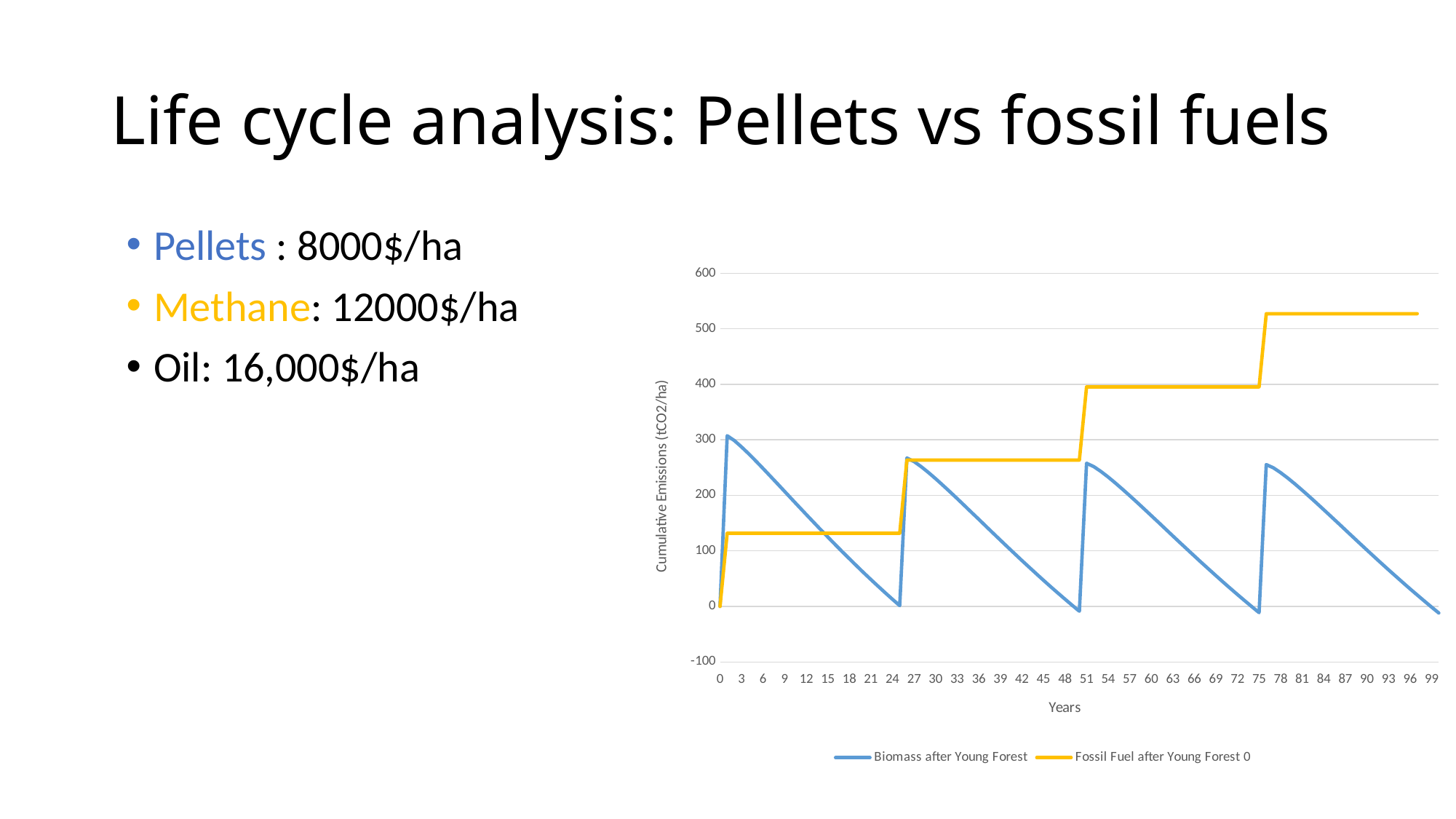
Is the value of Fossil Fuel after Young Forest 0 at year 90 greater or less than 500? greater At year 12, which series has the higher value, Biomass after Young Forest or Fossil Fuel after Young Forest 0? Biomass after Young Forest Which series is drawn in yellow on the chart? Fossil Fuel after Young Forest 0 What kind of chart is shown on the slide? line chart Is the value of Biomass after Young Forest at year 12 greater or less than 100? greater What is the title of the vertical axis of the chart? Cumulative Emissions (tCO2/ha) Does the Fossil Fuel after Young Forest 0 series rise or fall overall from year 0 to year 99? rise Is the value of Biomass after Young Forest at year 24 greater or less than 100? less How many series does the chart legend list? 2 At year 90, which series has the higher value, Biomass after Young Forest or Fossil Fuel after Young Forest 0? Fossil Fuel after Young Forest 0